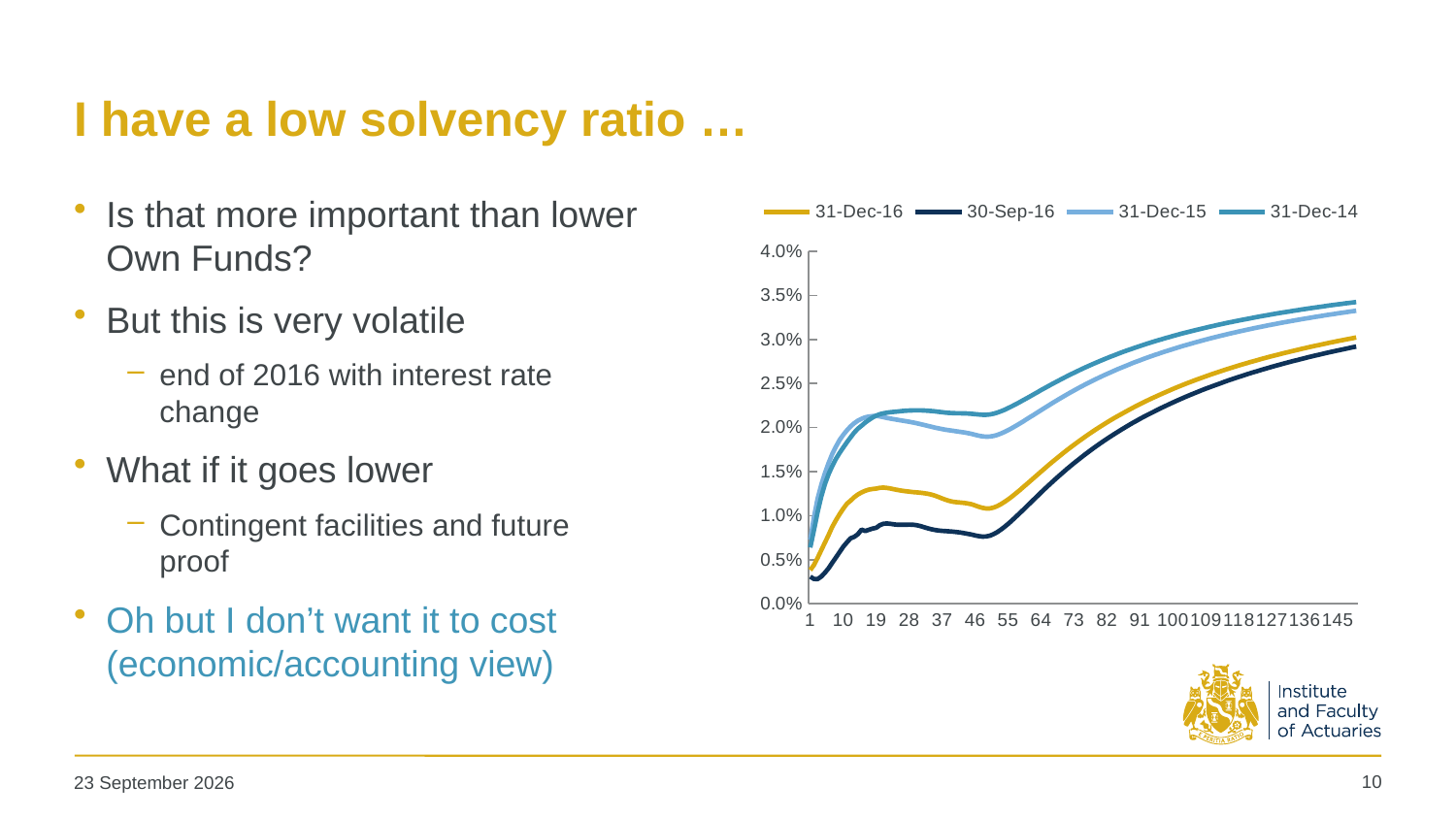
Which series has the lowest value at the right-hand end of the chart (x = 145)? 30-Sep-16 At x = 28, which series is larger: 31-Dec-15 or 31-Dec-16? 31-Dec-15 Is the value of the 31-Dec-16 series at x = 28 greater or less than 1.0%? greater What kind of chart is shown on the slide? Line chart Which series has the highest value at the right-hand end of the chart (x = 145)? 31-Dec-14 Which series has the lowest value at the left-hand start of the chart (x = 1)? 30-Sep-16 Is the value of the 30-Sep-16 series at x = 1 greater or less than 0.5%? less What is the highest value shown on the chart's vertical axis? 4.0% How many series does the chart's legend list? 4 Overall, do the series values rise or fall from the left to the right of the chart? rise Is the value of the 31-Dec-14 series at x = 145 greater or less than 3.0%? greater What are the four series named in the chart's legend? 31-Dec-16, 30-Sep-16, 31-Dec-15, 31-Dec-14